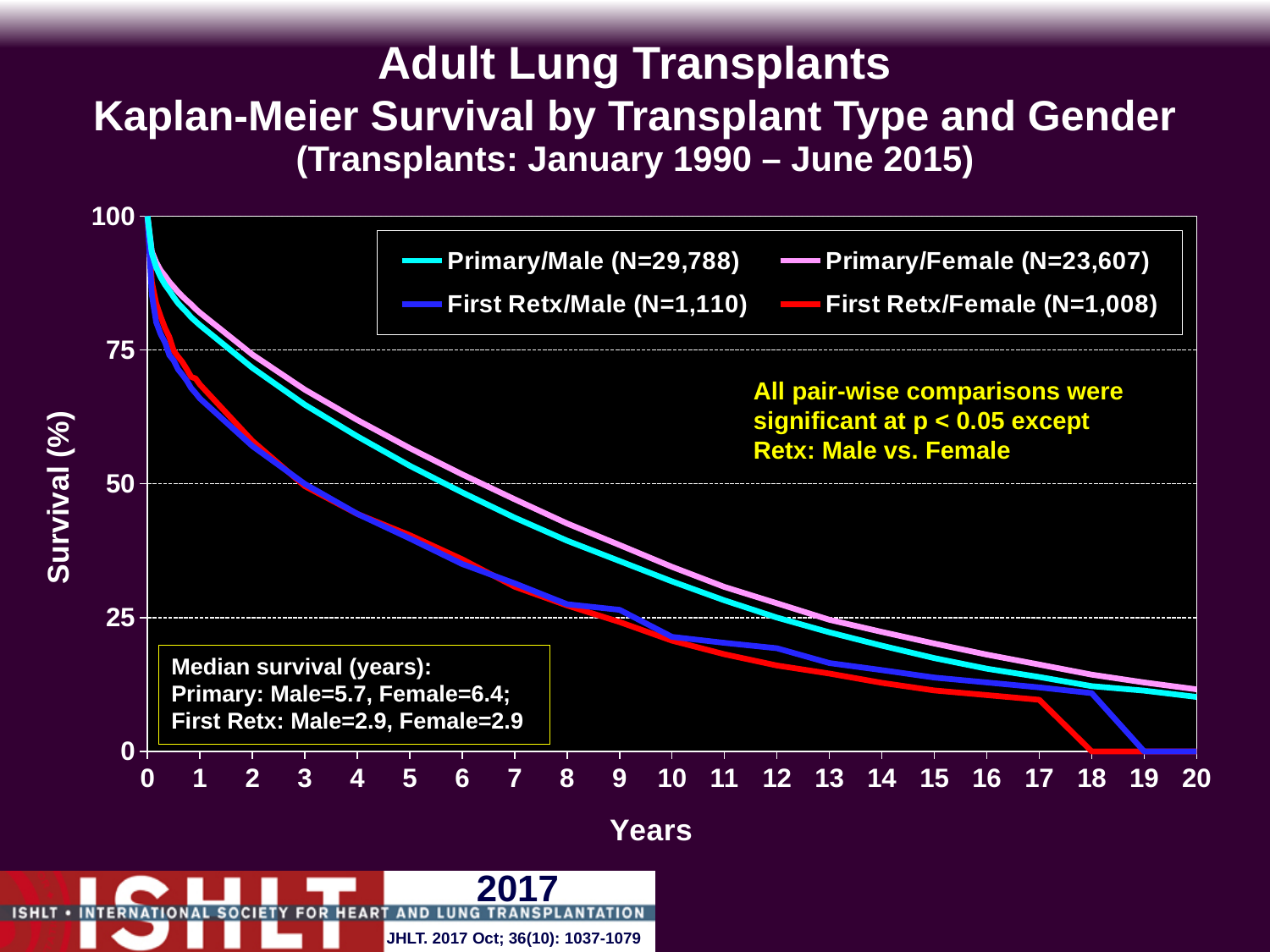
How many series does the legend list? 4 At 10 years, which series has higher survival: Primary/Female or Primary/Male? Primary/Female What is the median survival in years for Primary/Male transplants? 5.7 What is the difference in median survival (years) between Primary/Female and Primary/Male? 0.7 What is the median survival in years for First Retx/Male transplants? 2.9 Which series has the highest survival at 15 years? Primary/Female Is the survival for First Retx/Female at 10 years greater or less than 25%? less Do the survival curves rise or fall as years increase along the x axis? Fall What is the median survival in years for Primary/Female transplants? 6.4 Is the survival for Primary/Female at 5 years greater or less than 50%? greater What kind of chart is shown on the slide? Line chart What is the N for the Primary/Male series shown in the legend? 29,788